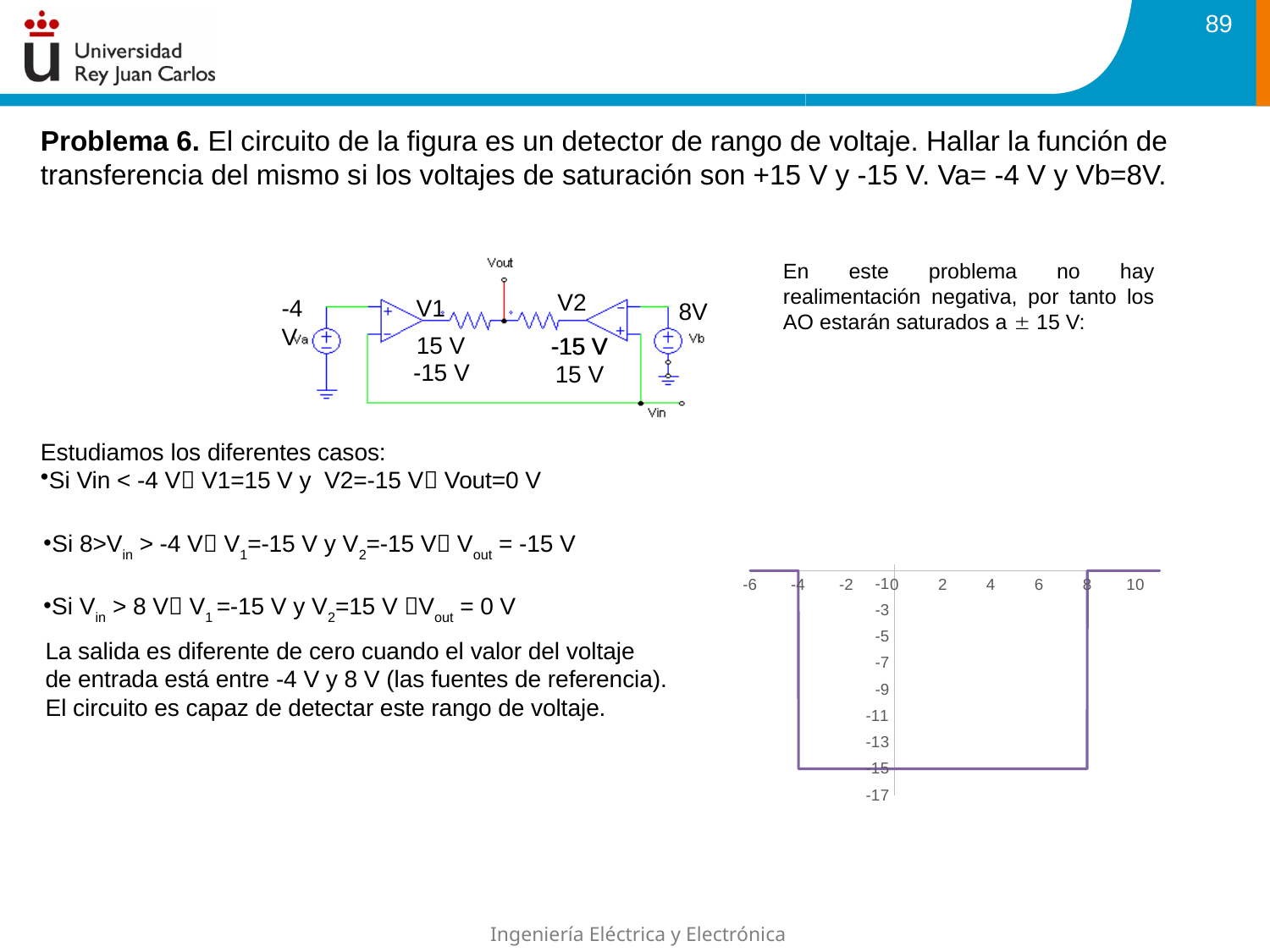
In the chart at the bottom right, at which x-axis value does the line rise sharply back up? 8 In the chart at the bottom right, which is larger: the value of the line at x = 0 or at x = 10? x = 10 In the chart at the bottom right, at which x-axis value does the line drop sharply downward? -4 In the chart at the bottom right, what is the lowest value the line reaches? -15 In the chart at the bottom right, what is the highest tick label shown on the x axis? 10 What kind of chart is shown at the bottom right of the slide? line chart In the chart at the bottom right, does the line rise or fall as x goes from -6 to -2? fall In the chart at the bottom right, what is the value of the line for x values between -4 and 8? -15 In the chart at the bottom right, is the value of the line at x = 2 greater or less than -10? less In the chart at the bottom right, is the value of the line at x = -6 greater or less than -10? greater In the chart at the bottom right, what is the lowest tick label shown on the y axis? -17